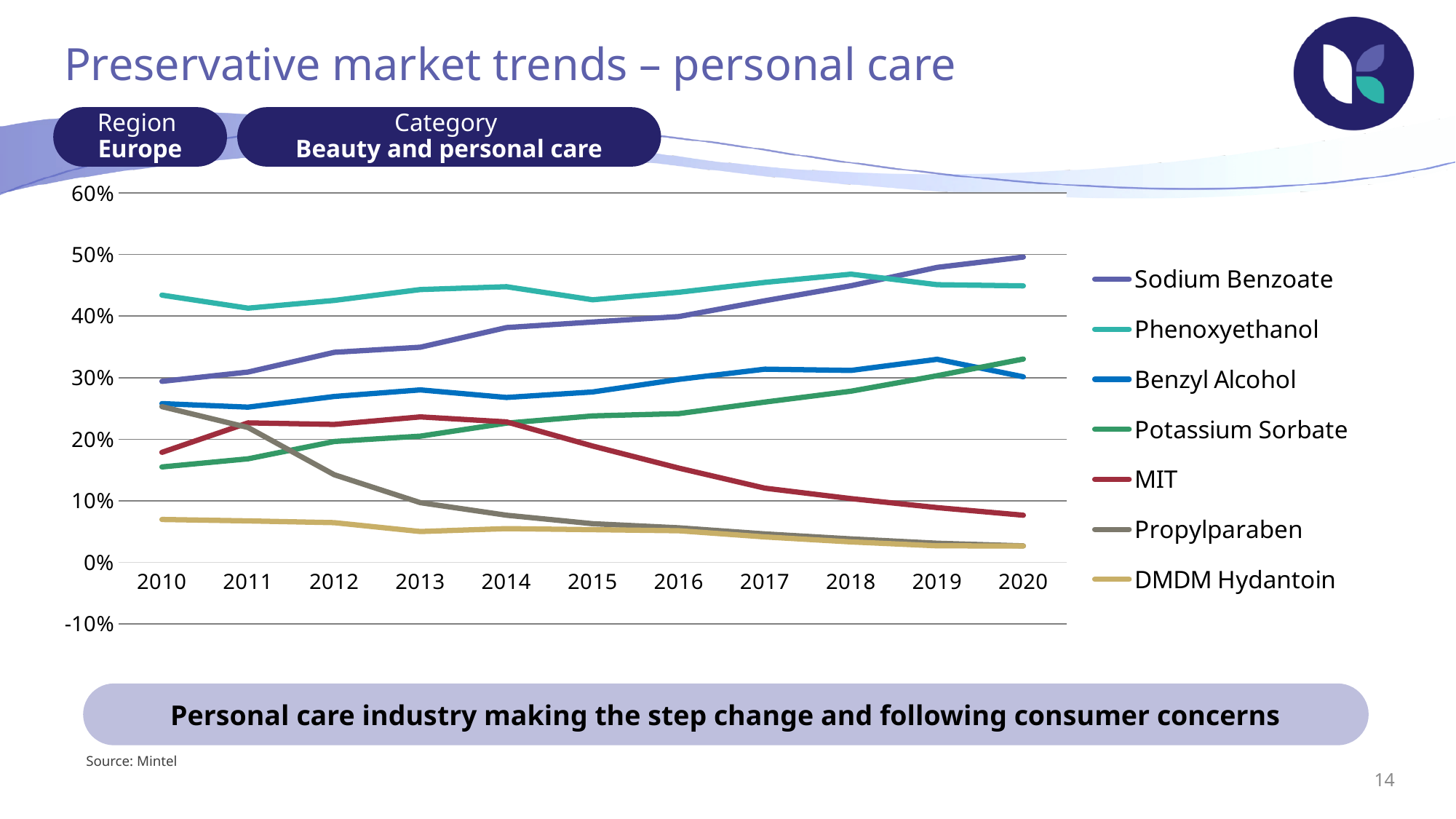
Which series has the lowest value in 2010? DMDM Hydantoin Is the value for Sodium Benzoate in 2020 greater or less than 40%? greater Does the Sodium Benzoate line rise or fall from 2010 to 2020? rise In 2010, which is higher: Phenoxyethanol or Sodium Benzoate? Phenoxyethanol Which series has the highest value in 2020? Sodium Benzoate How many years are shown on the x axis? 11 Which region does the chart cover, according to the label above it? Europe What kind of chart is shown on the slide? line chart How many series does the legend list? 7 Is the value for MIT in 2020 greater or less than 10%? less Does the Propylparaben line rise or fall from 2010 to 2020? fall Is the value for Propylparaben in 2010 greater or less than 20%? greater